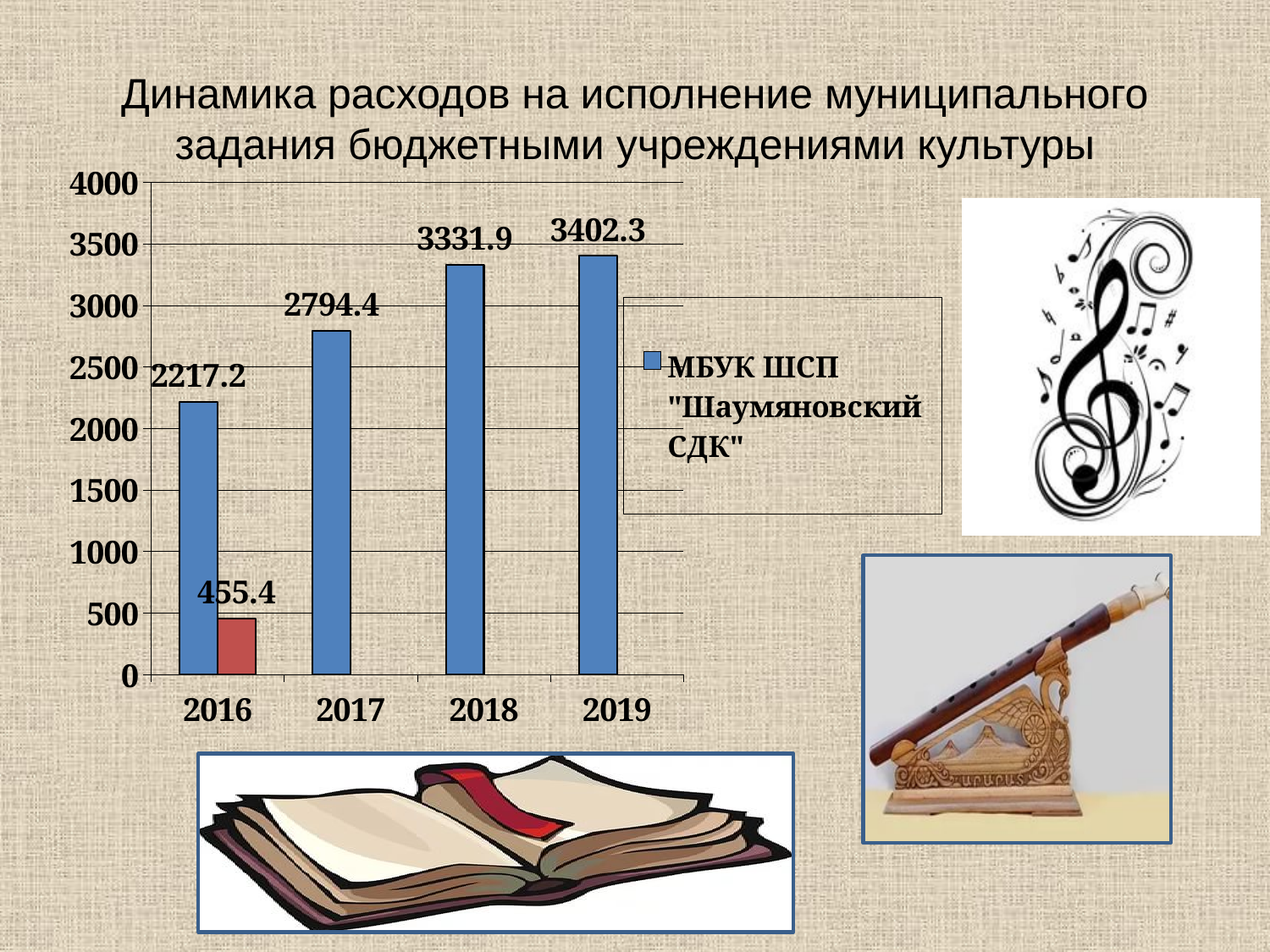
In which year is the value for МБУК ШСП "Шаумяновский СДК" the highest? 2019 What is the value for МБУК ШСП "Шаумяновский СДК" in 2019? 3402.3 How many years are shown on the x axis of the chart? 4 Do the values for МБУК ШСП "Шаумяновский СДК" rise or fall from 2016 to 2019? rise What type of chart is shown on the slide? bar chart What value is printed on the red bar in 2016? 455.4 What is the value for МБУК ШСП "Шаумяновский СДК" in 2018? 3331.9 What is the value for МБУК ШСП "Шаумяновский СДК" in 2016? 2217.2 What is the difference between the 2019 and 2016 values for МБУК ШСП "Шаумяновский СДК"? 1185.1 In which year is the value for МБУК ШСП "Шаумяновский СДК" the lowest? 2016 What is the value for МБУК ШСП "Шаумяновский СДК" in 2017? 2794.4 Which year has the larger value for МБУК ШСП "Шаумяновский СДК", 2017 or 2018? 2018